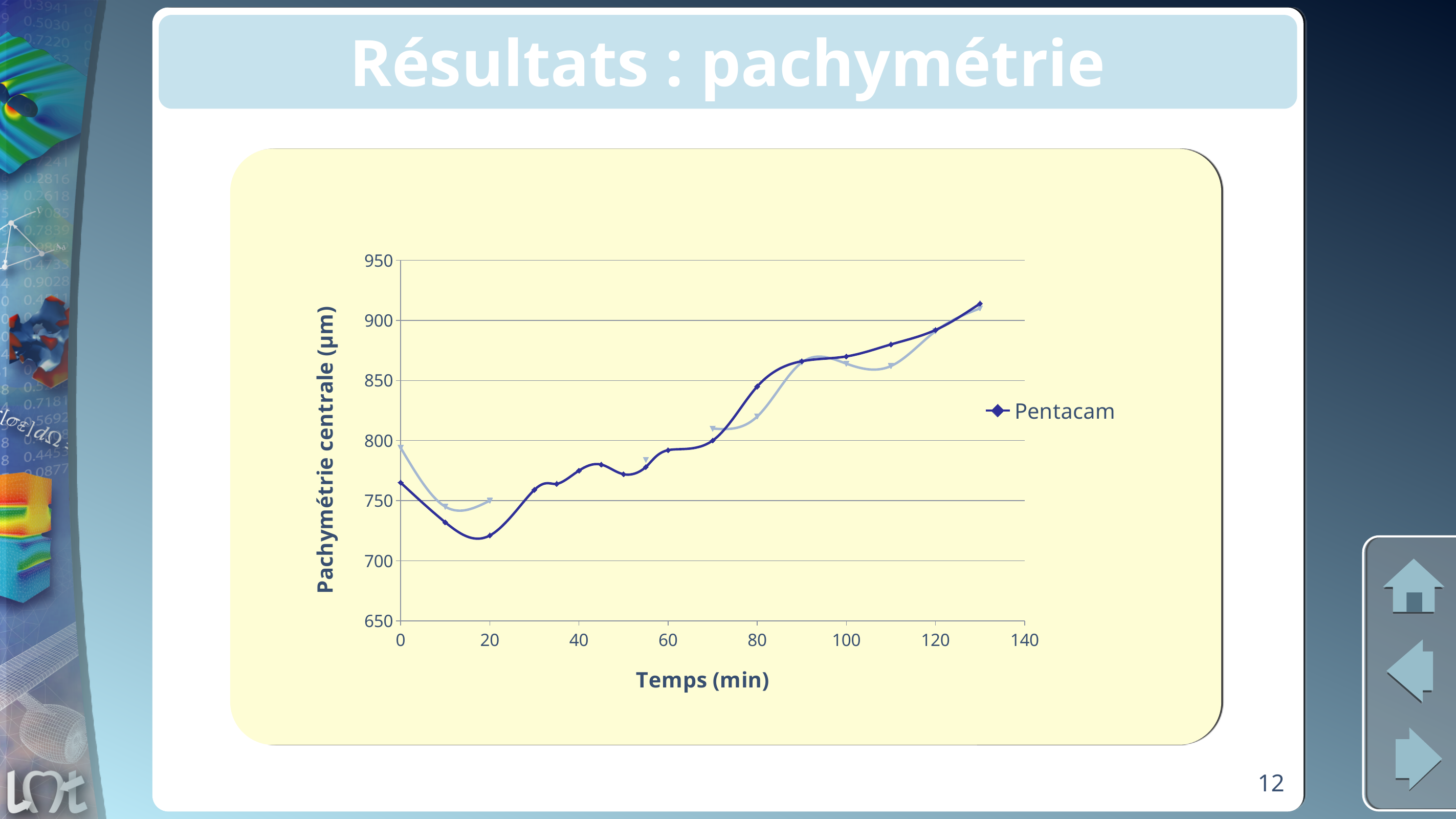
Is the Pentacam value at 0 min greater or less than 750? greater Is the Pentacam value at 130 min greater or less than 900? greater What is the label of the vertical axis? Pachymétrie centrale (µm) What kind of chart is shown on the slide? line chart What is the name of the series listed in the legend? Pentacam Is the Pentacam value at 20 min greater or less than 750? less Which is larger for the Pentacam series: the value at 0 min or the value at 20 min? 0 min How many series does the legend list? 1 At which time (in min) does the Pentacam series reach its highest value? 130 At which time (in min) does the Pentacam series reach its lowest value? 20 From 20 min to 130 min, does the Pentacam series generally rise or fall? rise